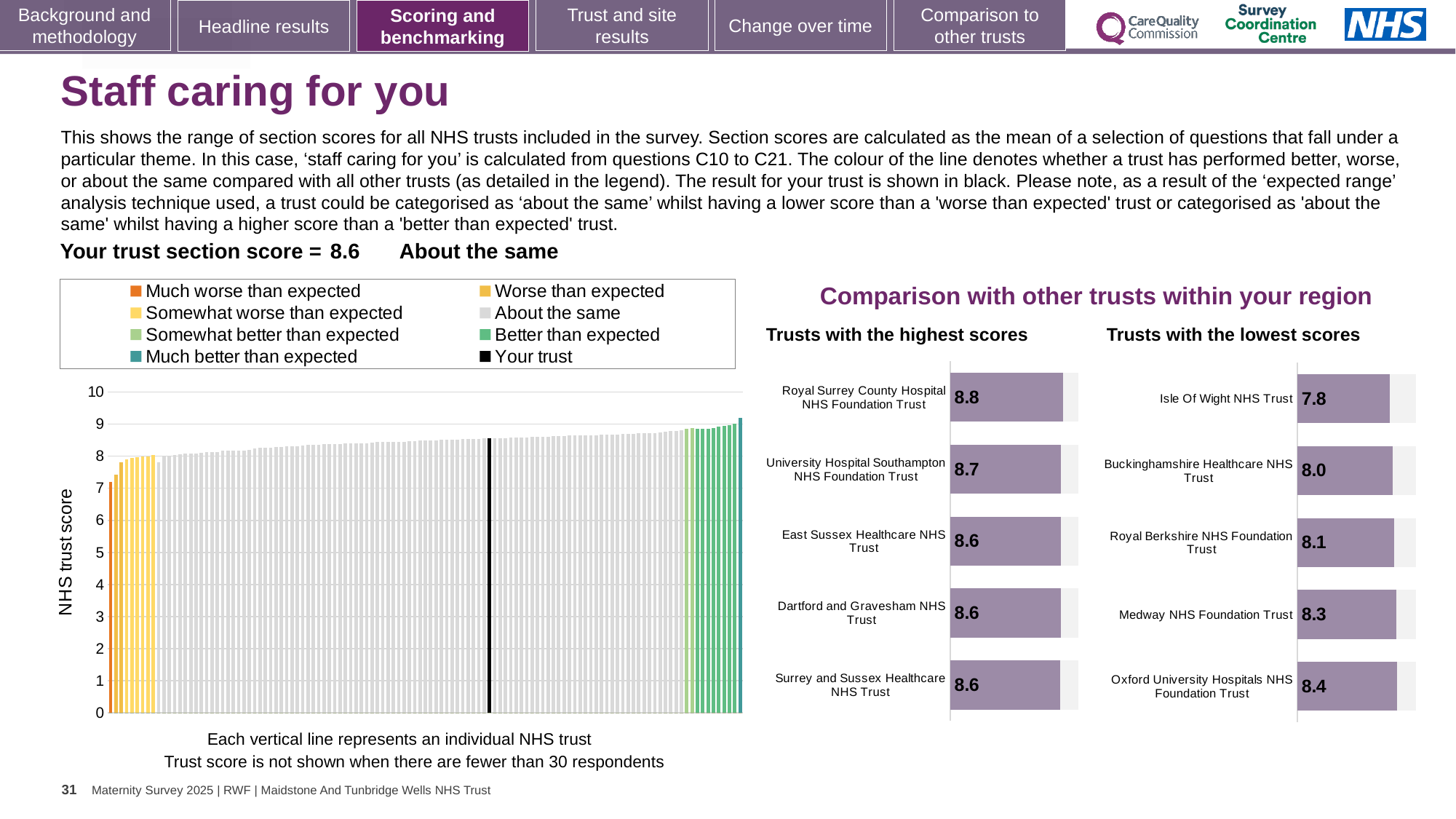
What is the difference between the score for Royal Surrey County Hospital NHS Foundation Trust in the highest scores chart and the score for Isle Of Wight NHS Trust in the lowest scores chart? 1.0 In the 'Trusts with the lowest scores' chart, what is the score for Medway NHS Foundation Trust? 8.3 In the 'Trusts with the highest scores' chart, which trust has the highest score? Royal Surrey County Hospital NHS Foundation Trust How many entries does the legend of the main 'NHS trust score' chart list? 8 How many trusts are shown in the 'Trusts with the highest scores' chart? 5 In the main 'NHS trust score' chart, do the values rise or fall from left to right? Rise What kind of chart is the main chart on the left showing NHS trust scores? Bar chart In the 'Trusts with the lowest scores' chart, which trust has the lowest score? Isle Of Wight NHS Trust In the 'Trusts with the highest scores' chart, what is the score for Royal Surrey County Hospital NHS Foundation Trust? 8.8 In the 'Trusts with the lowest scores' chart, which has the larger score: Buckinghamshire Healthcare NHS Trust or Oxford University Hospitals NHS Foundation Trust? Oxford University Hospitals NHS Foundation Trust In the 'Trusts with the lowest scores' chart, what is the score for Isle Of Wight NHS Trust? 7.8 What is the section score for your trust shown on the slide? 8.6